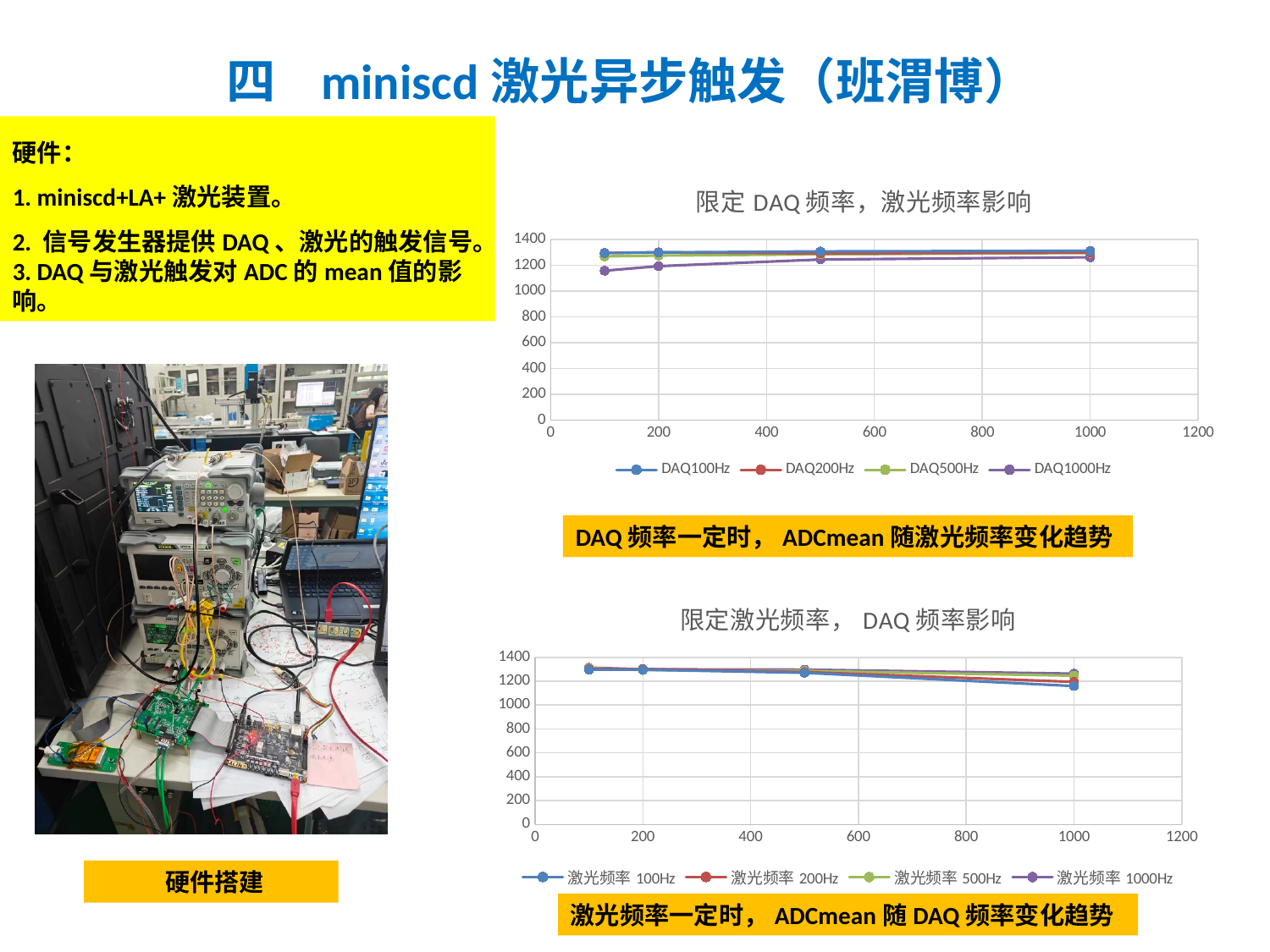
How many series does the legend of the top chart (限定 DAQ 频率，激光频率影响) list? 4 In the top chart (限定 DAQ 频率，激光频率影响), how many data points does the DAQ1000Hz series have? 4 In the top chart (限定 DAQ 频率，激光频率影响), does the DAQ1000Hz series rise or fall as x increases from 100 to 1000? rise In the top chart (限定 DAQ 频率，激光频率影响), is the value of the DAQ1000Hz series at x = 100 greater or less than 1200? less In the bottom chart (限定激光频率，DAQ 频率影响), does the 激光频率 100Hz series rise or fall as x increases from 100 to 1000? fall In the top chart (限定 DAQ 频率，激光频率影响), which legend entry is drawn in purple? DAQ1000Hz In the bottom chart (限定激光频率，DAQ 频率影响), is the value of the 激光频率 100Hz series at x = 1000 greater or less than 1200? less How many series does the legend of the bottom chart (限定激光频率，DAQ 频率影响) list? 4 What kind of chart is the top chart titled 限定 DAQ 频率，激光频率影响? line chart In the top chart (限定 DAQ 频率，激光频率影响), which series has the lowest value at x = 100? DAQ1000Hz In the top chart (限定 DAQ 频率，激光频率影响), is the value of the DAQ100Hz series at x = 100 greater or less than 1200? greater What is the title of the bottom chart on the slide? 限定激光频率，DAQ 频率影响